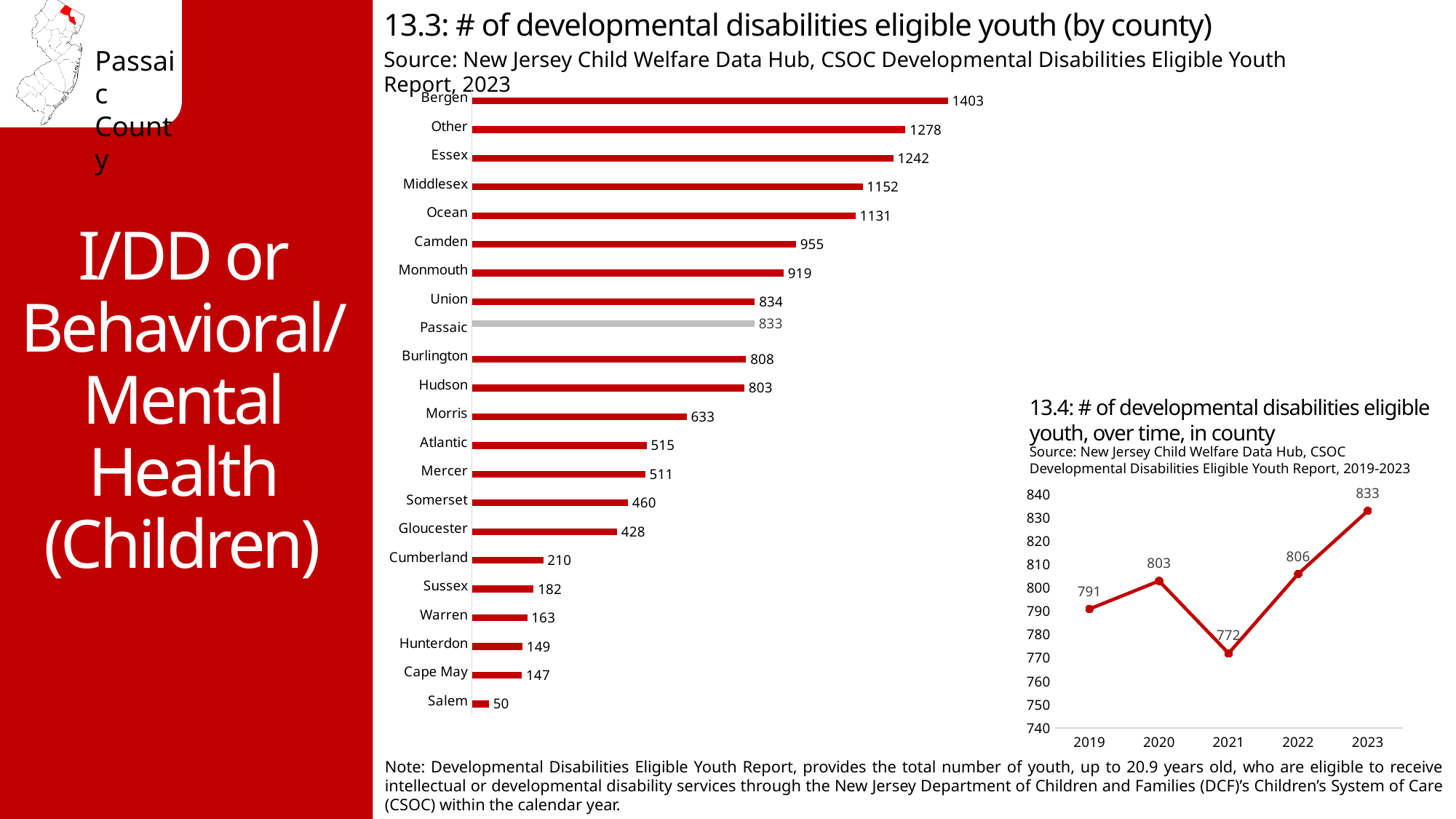
In the chart '13.3: # of developmental disabilities eligible youth (by county)', which is larger, Camden or Monmouth? Camden In the chart '13.4: # of developmental disabilities eligible youth, over time, in county', which year has the highest value? 2023 In the chart '13.3: # of developmental disabilities eligible youth (by county)', which county has the highest value? Bergen In the chart '13.3: # of developmental disabilities eligible youth (by county)', how many categories are shown? 22 What kind of chart is '13.3: # of developmental disabilities eligible youth (by county)'? Bar chart In the chart '13.4: # of developmental disabilities eligible youth, over time, in county', what is the difference between 2023 and 2019? 42 What kind of chart is '13.4: # of developmental disabilities eligible youth, over time, in county'? Line chart In the chart '13.4: # of developmental disabilities eligible youth, over time, in county', what is the value for 2021? 772 In the chart '13.3: # of developmental disabilities eligible youth (by county)', what is the difference between Bergen and Essex? 161 In the chart '13.3: # of developmental disabilities eligible youth (by county)', what is the value for Cumberland? 210 In the chart '13.3: # of developmental disabilities eligible youth (by county)', what is the value for Passaic? 833 In the chart '13.3: # of developmental disabilities eligible youth (by county)', which county has the lowest value? Salem